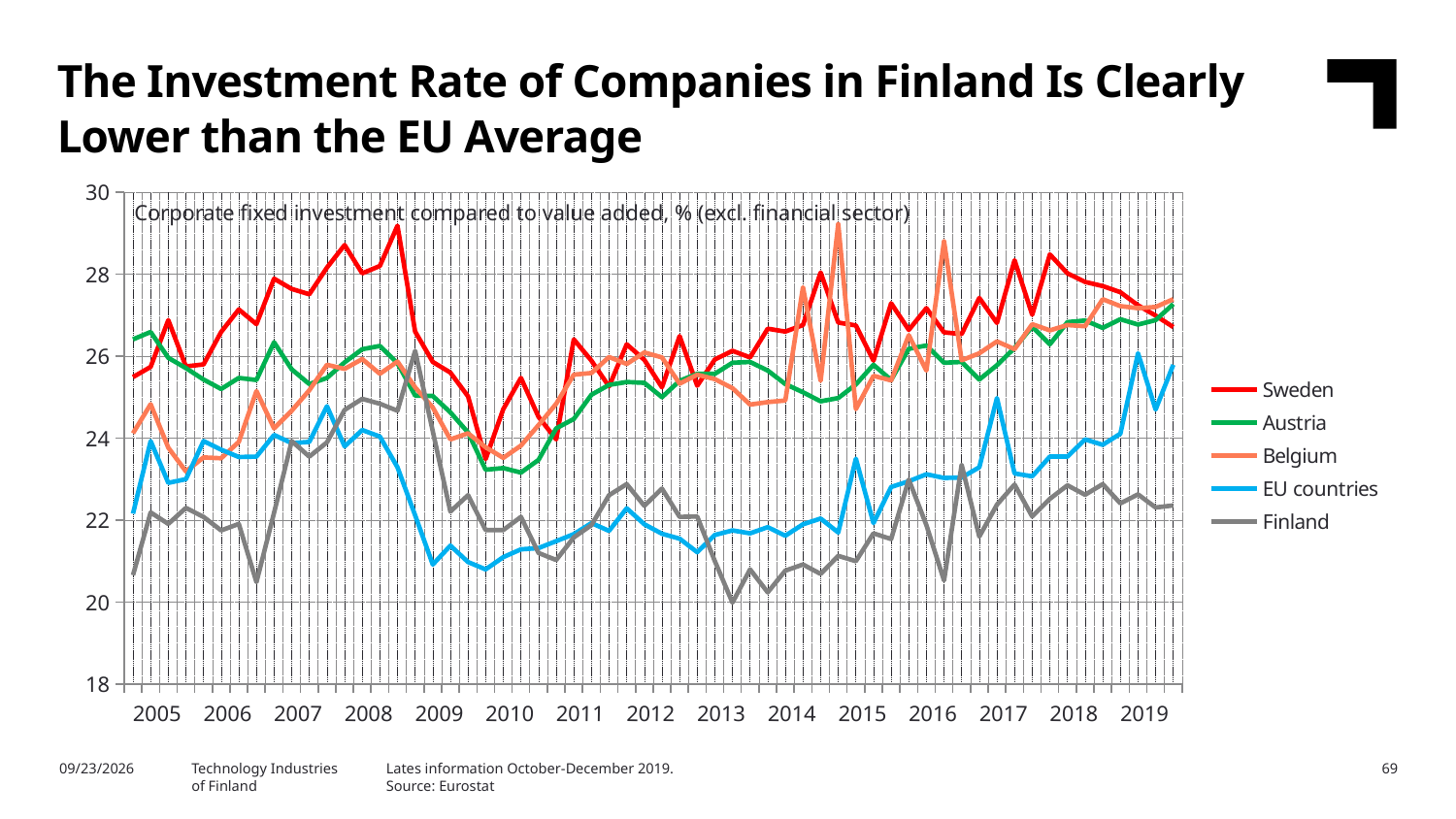
Which series is the lowest across most of the period shown? Finland How many series does the legend list? 5 Is the value for Finland at its lowest point in 2013 greater or less than 22? less What kind of chart is shown on the slide? line chart How many years are labelled on the x axis? 15 In 2008, which is larger, the value for Sweden or the value for Finland? Sweden Does the value for Sweden rise or fall from its 2008 peak to 2009? fall What is the subtitle printed inside the chart area? Corporate fixed investment compared to value added, % (excl. financial sector) Which series is the highest in 2008? Sweden Which series are listed in the legend? Sweden, Austria, Belgium, EU countries, Finland Is the value for Sweden at its peak in 2008 greater or less than 28? greater